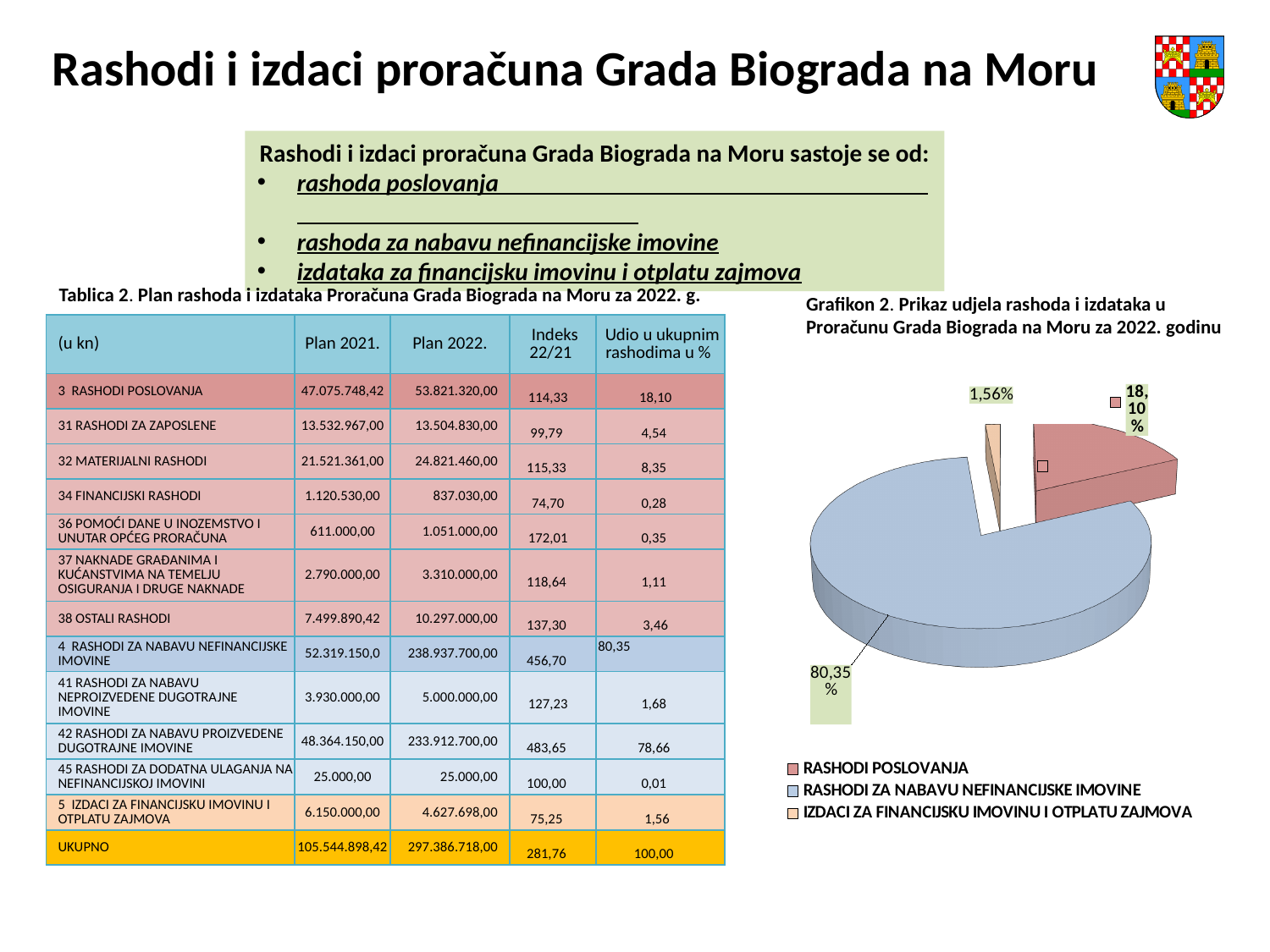
Which legend entry is shown in red/pink in the pie chart? RASHODI POSLOVANJA How many entries does the chart legend list? 3 What is the title of the chart on the slide? Grafikon 2. Prikaz udjela rashoda i izdataka u Proračunu Grada Biograda na Moru za 2022. godinu What share of the pie does IZDACI ZA FINANCIJSKU IMOVINU I OTPLATU ZAJMOVA represent? 1,56% What share of the pie does RASHODI POSLOVANJA represent? 18,10% Which is larger in the pie chart: RASHODI POSLOVANJA or IZDACI ZA FINANCIJSKU IMOVINU I OTPLATU ZAJMOVA? RASHODI POSLOVANJA What is the difference in percentage points between the RASHODI ZA NABAVU NEFINANCIJSKE IMOVINE slice and the RASHODI POSLOVANJA slice? 62,25 Which category has the smallest slice of the pie? IZDACI ZA FINANCIJSKU IMOVINU I OTPLATU ZAJMOVA How many slices does the pie chart have? 3 What kind of chart is shown on the slide? Pie chart What share of the pie does RASHODI ZA NABAVU NEFINANCIJSKE IMOVINE represent? 80,35% Which category has the largest slice of the pie? RASHODI ZA NABAVU NEFINANCIJSKE IMOVINE